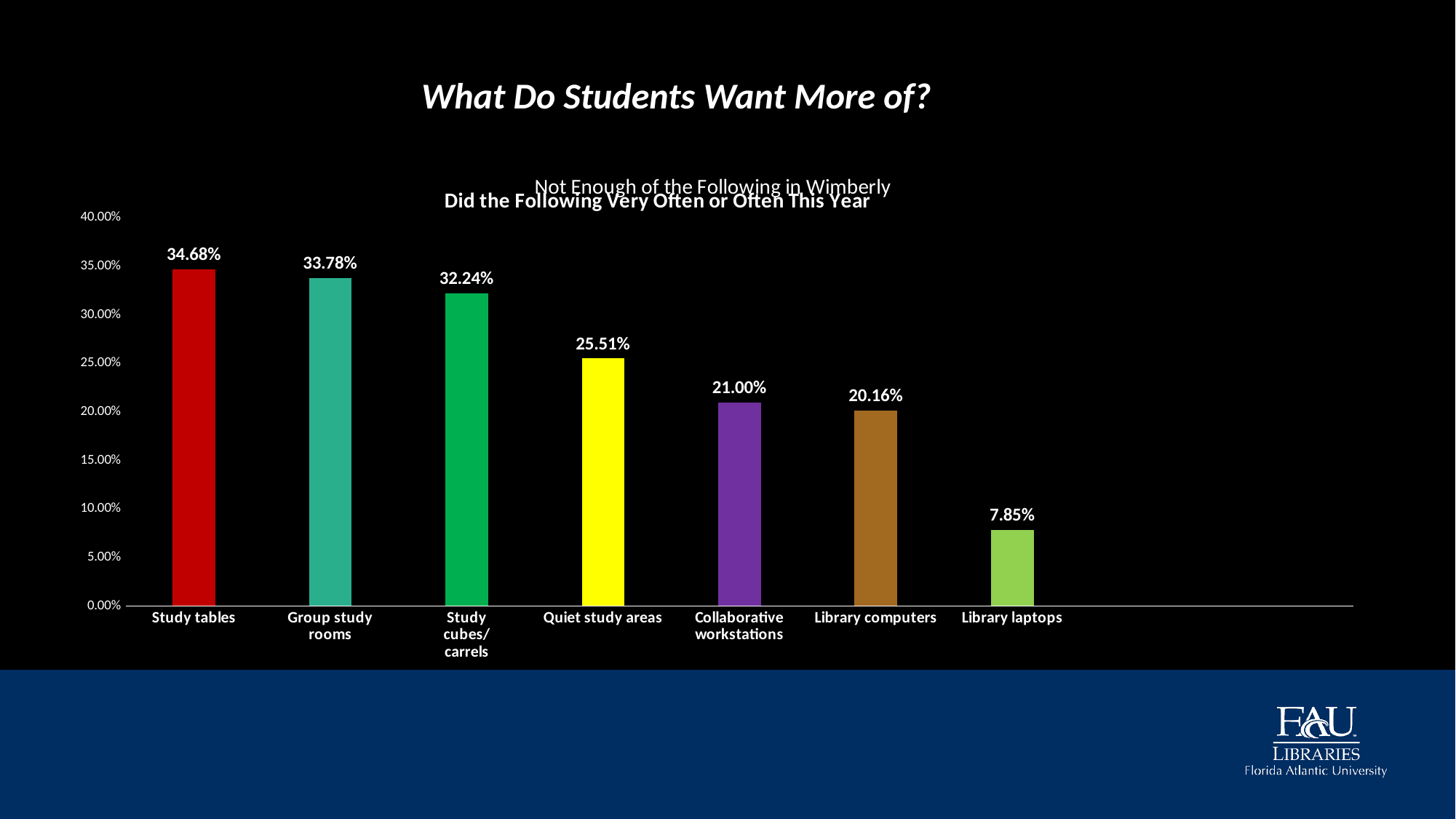
What is the difference between the values for Group study rooms and Library computers? 13.62% What is the value for Quiet study areas? 25.51% Which is larger, the value for Study cubes/carrels or the value for Quiet study areas? Study cubes/carrels What is the value for Library laptops? 7.85% Which category has the lowest value? Library laptops What kind of chart is shown on the slide? bar chart What is the value for Collaborative workstations? 21.00% What is the value for Study tables? 34.68% What is the title of the slide? What Do Students Want More of? Is the value for Library computers greater or less than 25.00%? less Which category has the highest value? Study tables How many categories are shown in the chart? 7